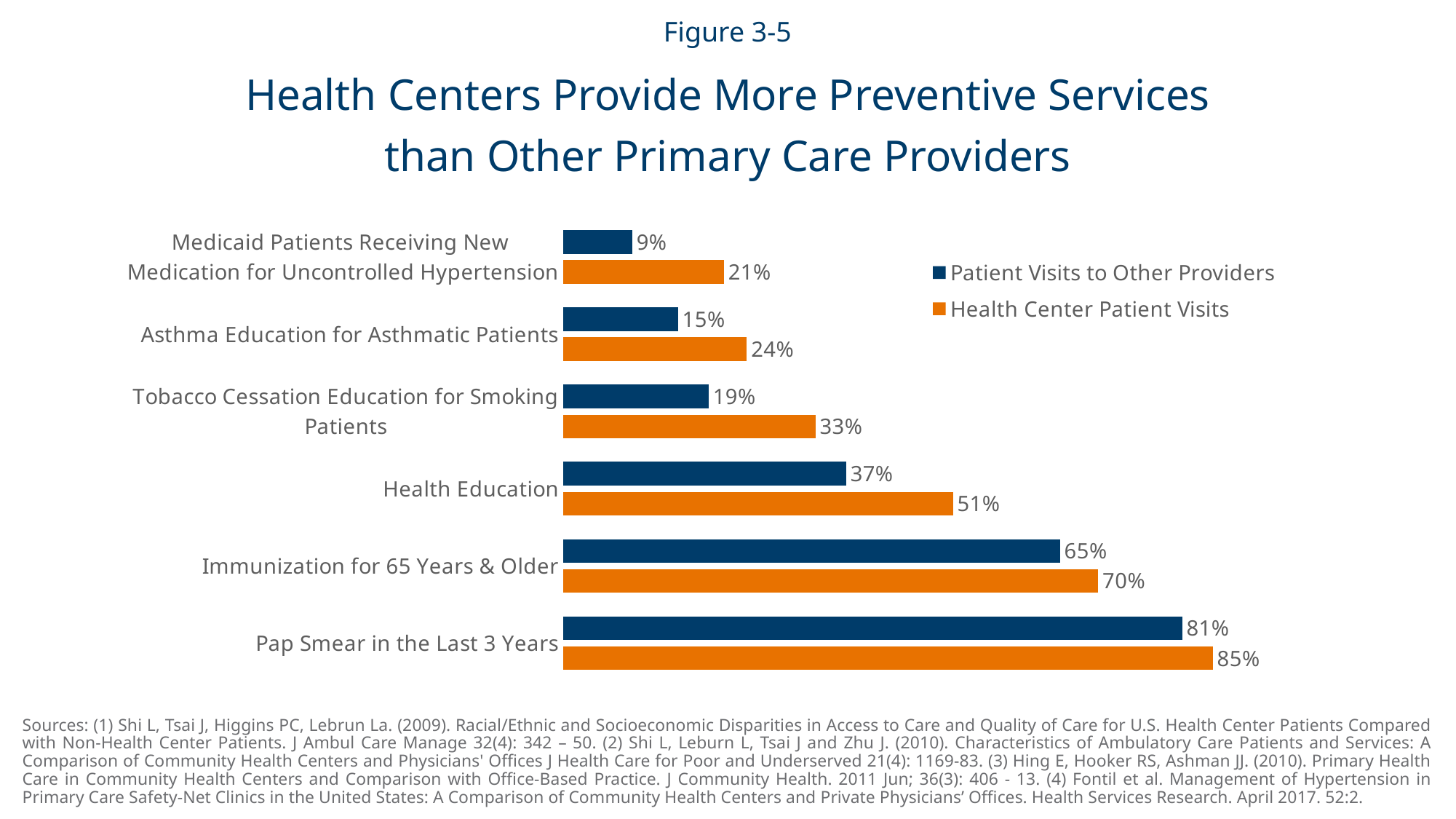
Which category has the lowest Patient Visits to Other Providers value? Medicaid Patients Receiving New Medication for Uncontrolled Hypertension What kind of chart is shown on the slide? Bar chart Which category has the highest Health Center Patient Visits value? Pap Smear in the Last 3 Years Which is larger for Health Education: Health Center Patient Visits or Patient Visits to Other Providers? Health Center Patient Visits What is the difference between Health Center Patient Visits and Patient Visits to Other Providers for Immunization for 65 Years & Older? 5% What is the Health Center Patient Visits value for Tobacco Cessation Education for Smoking Patients? 33% Which colour represents Health Center Patient Visits in the chart? Orange What is the difference between Health Center Patient Visits and Patient Visits to Other Providers for Medicaid Patients Receiving New Medication for Uncontrolled Hypertension? 12% What is the Health Center Patient Visits value for Health Education? 51% What is the Patient Visits to Other Providers value for Asthma Education for Asthmatic Patients? 15% How many series does the legend list? 2 How many categories are shown in the chart? 6